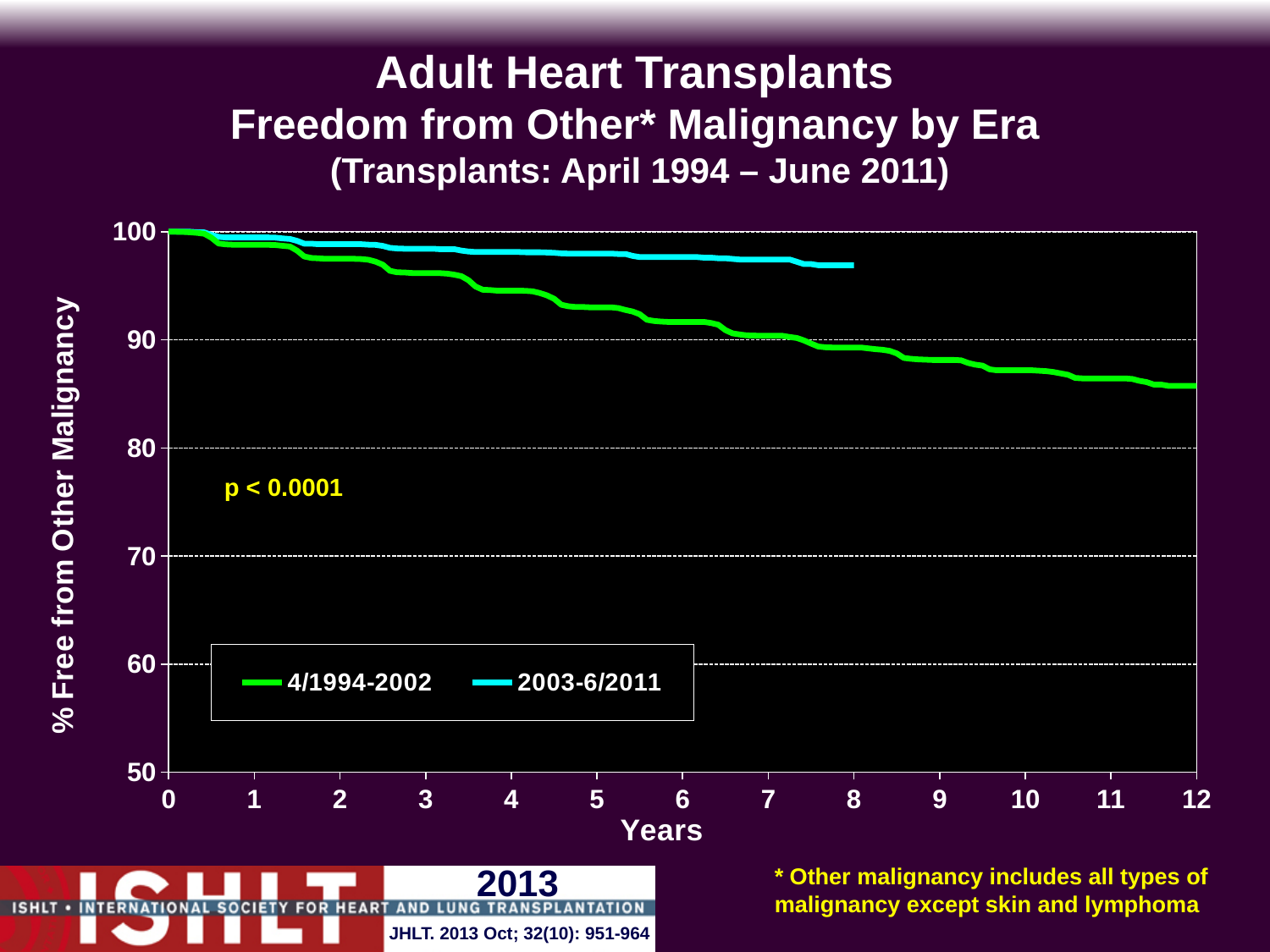
Is the value for the 4/1994-2002 series at year 10 greater or less than 90? less Do the values for the 2003-6/2011 series rise or fall as years increase? fall Is the value for the 4/1994-2002 series at year 4 greater or less than 90? greater Which series reaches the lowest value on the chart? 4/1994-2002 At year 6, which series has the higher value, 4/1994-2002 or 2003-6/2011? 2003-6/2011 Is the value for the 2003-6/2011 series at year 8 greater or less than 90? greater How many series does the legend list? 2 Do the values for the 4/1994-2002 series rise or fall as years increase? fall Which two eras are listed in the legend? 4/1994-2002 and 2003-6/2011 What kind of chart is shown on the slide? line chart What p-value is printed on the chart? p < 0.0001